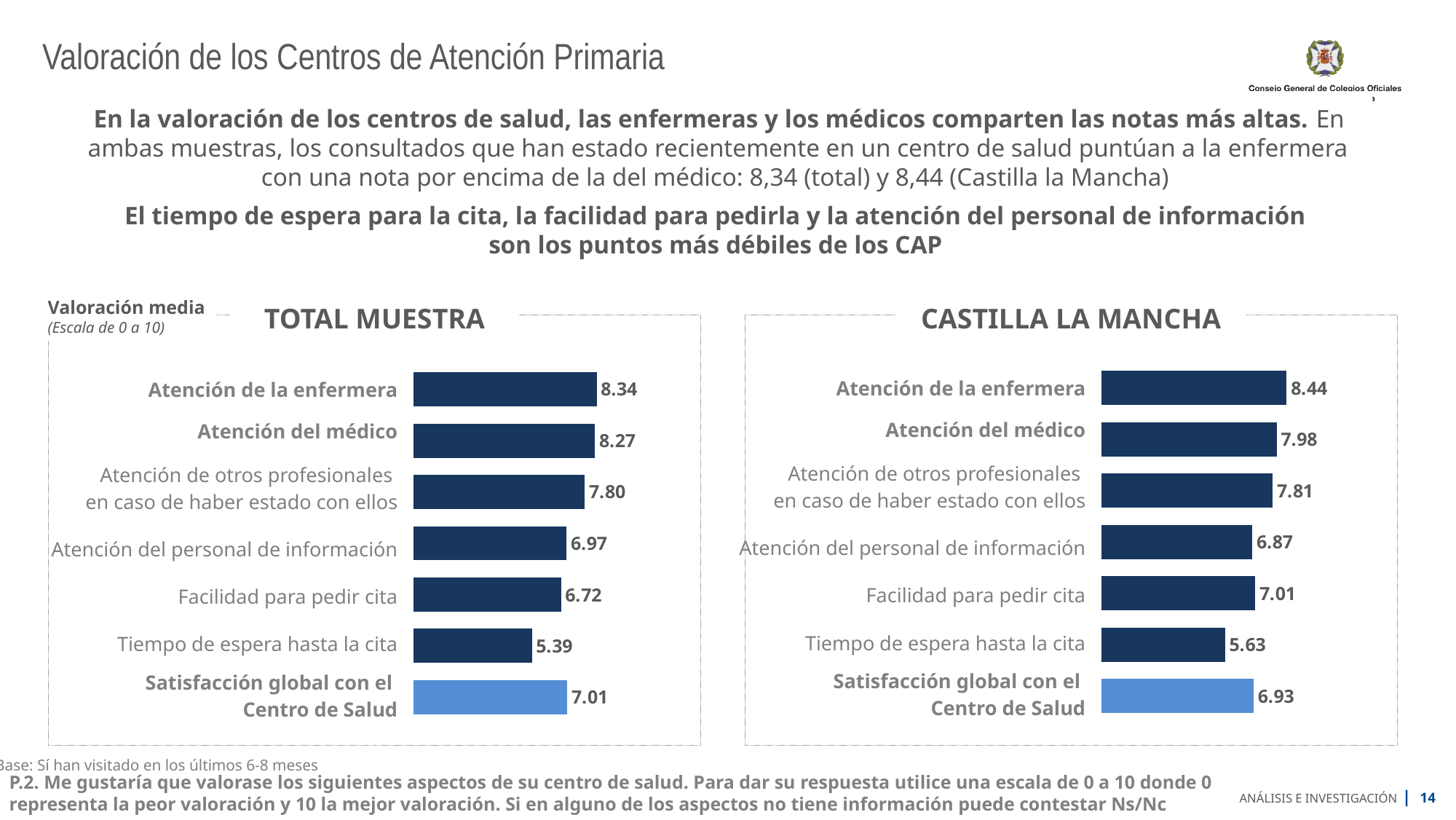
In the TOTAL MUESTRA chart, which is larger: Atención del personal de información or Facilidad para pedir cita? Atención del personal de información In the TOTAL MUESTRA chart, what is the value for Atención de la enfermera? 8.34 In the CASTILLA LA MANCHA chart, what is the value for Satisfacción global con el Centro de Salud? 6.93 How many categories are shown in the TOTAL MUESTRA chart? 7 In the CASTILLA LA MANCHA chart, what is the difference between Atención de la enfermera and Tiempo de espera hasta la cita? 2.81 In the CASTILLA LA MANCHA chart, what is the value for Facilidad para pedir cita? 7.01 In the TOTAL MUESTRA chart, which category has the lowest value? Tiempo de espera hasta la cita In the CASTILLA LA MANCHA chart, which is larger: Atención del personal de información or Facilidad para pedir cita? Facilidad para pedir cita In the CASTILLA LA MANCHA chart, which category has the highest value? Atención de la enfermera In the TOTAL MUESTRA chart, which bar is shown in a lighter blue colour than the others? Satisfacción global con el Centro de Salud What type of chart is the CASTILLA LA MANCHA chart? Bar chart In the TOTAL MUESTRA chart, what is the difference between Atención de la enfermera and Atención del médico? 0.07